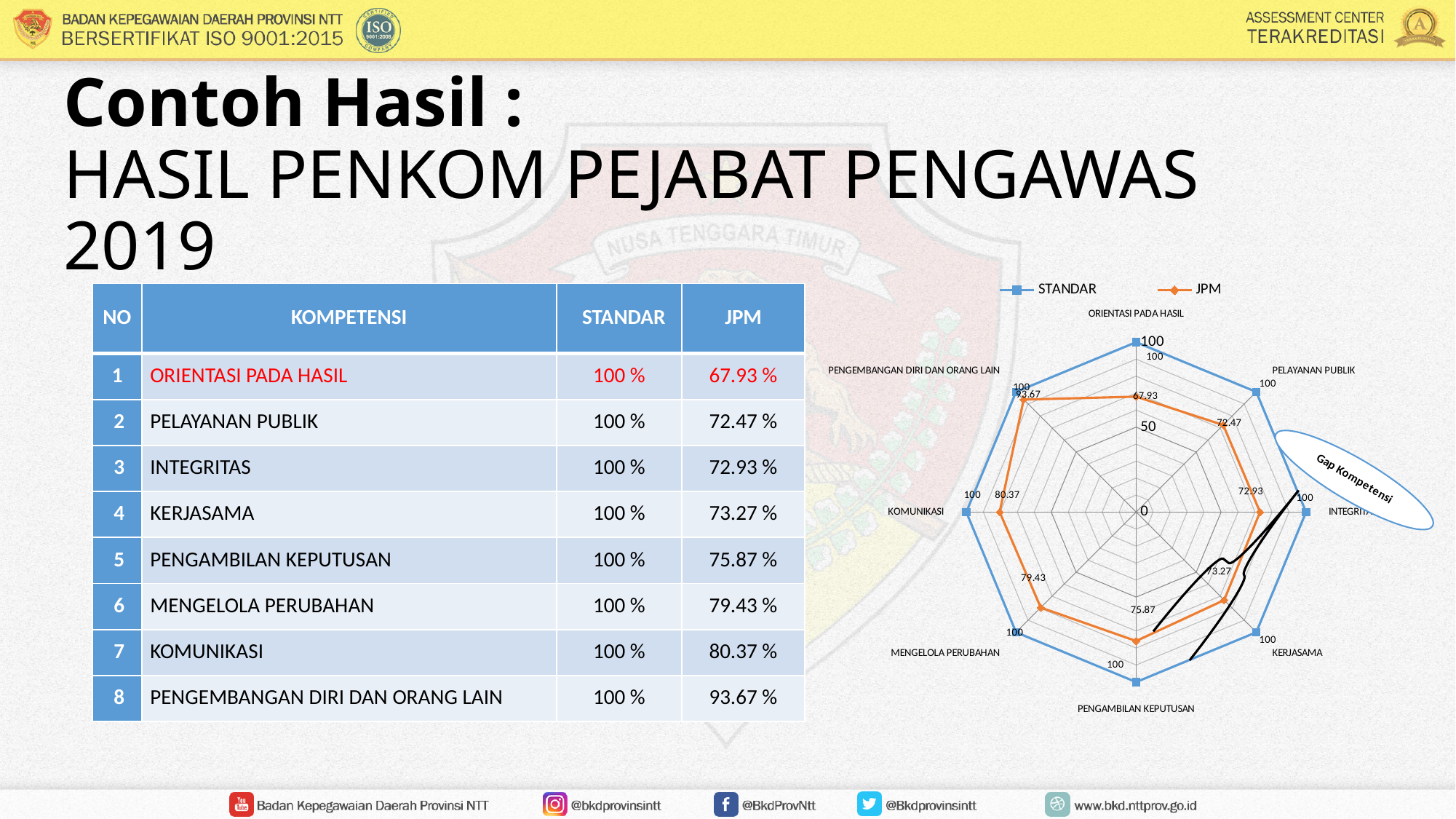
On the radar chart, which has the larger JPM value: KOMUNIKASI or MENGELOLA PERUBAHAN? KOMUNIKASI What kind of chart is shown on the right of the slide? radar chart On the radar chart, what is the difference between the STANDAR and JPM values for ORIENTASI PADA HASIL? 32.07 What is the JPM value for ORIENTASI PADA HASIL on the radar chart? 67.93 Is the JPM value for PENGAMBILAN KEPUTUSAN on the radar chart greater or less than 50? greater What is the JPM value for PENGEMBANGAN DIRI DAN ORANG LAIN on the radar chart? 93.67 How many series does the legend of the radar chart list? 2 How many competency categories are plotted on the radar chart? 8 Which category has the lowest JPM value on the radar chart? ORIENTASI PADA HASIL What is the STANDAR value for KERJASAMA on the radar chart? 100 Which category has the highest JPM value on the radar chart? PENGEMBANGAN DIRI DAN ORANG LAIN What is the JPM value for KOMUNIKASI on the radar chart? 80.37